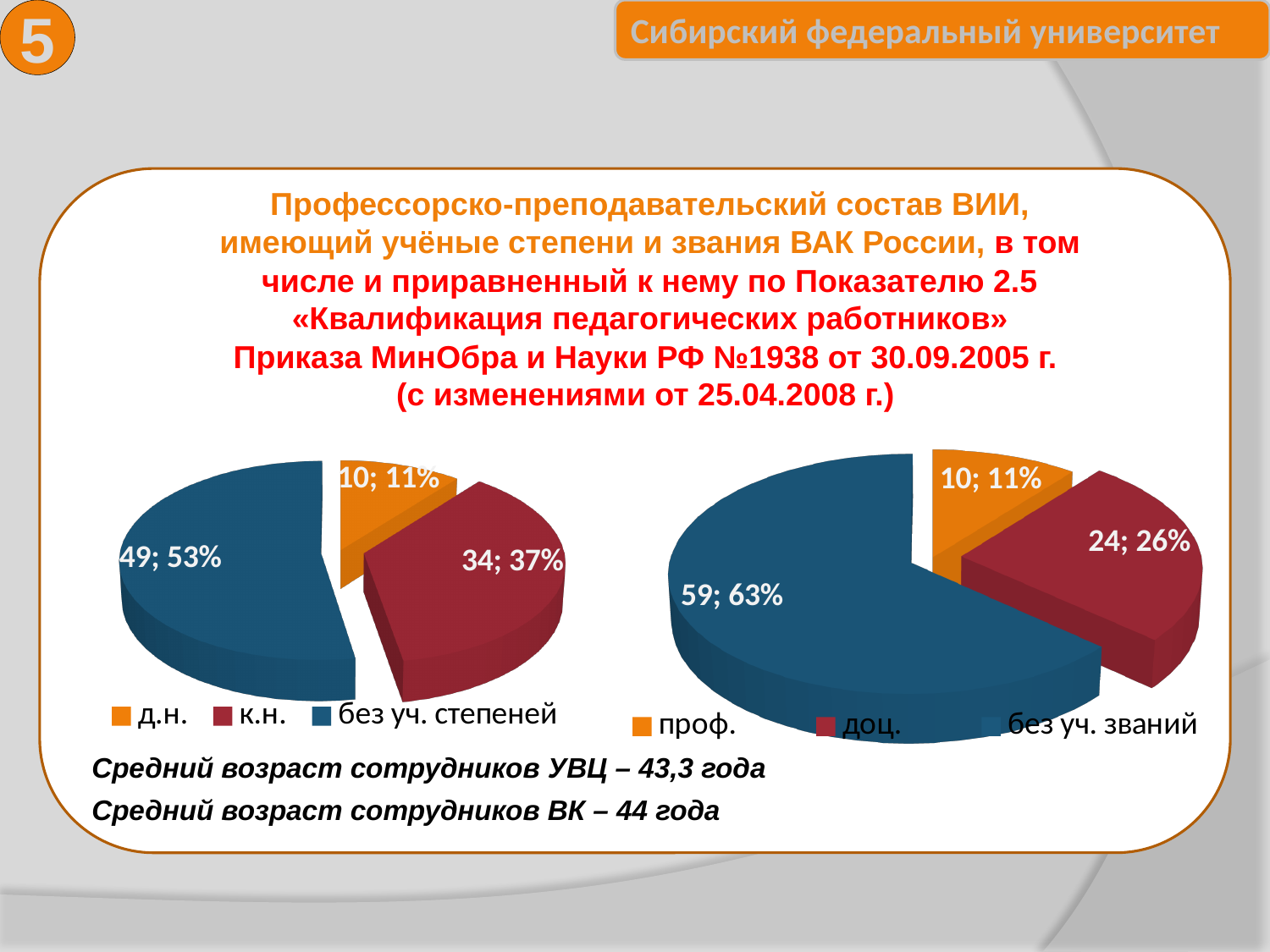
In the left pie chart, which category has the largest slice? без уч. степеней In the right pie chart, which category has the smallest slice? проф. In the left pie chart, what value is shown for к.н.? 34; 37% What type of chart is the left chart? Pie chart In the left pie chart, what is the difference between the counts for к.н. and д.н.? 24 In the right pie chart, what value is shown for без уч. званий? 59; 63% In the right pie chart, what share of the pie does проф. take? 11% In the right pie chart, what value is shown for доц.? 24; 26% How many categories does the legend of the right pie chart list? 3 In the right pie chart, which is larger, доц. or проф.? доц. In the left pie chart, what value is shown for д.н.? 10; 11% In the left pie chart, what share of the pie does без уч. степеней take? 53%